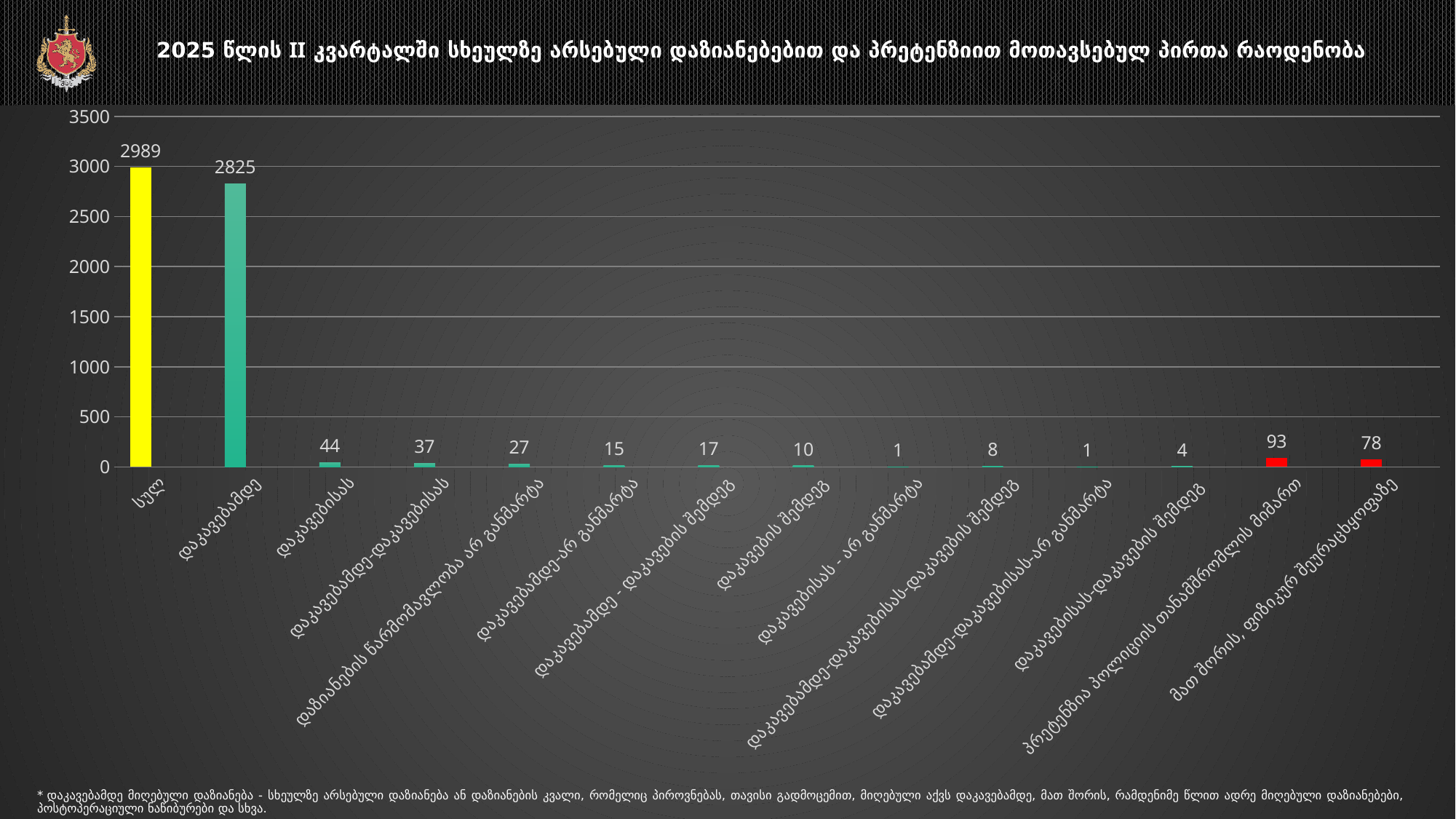
What is the value for პრეტენზია პოლიციის თანამშრომლის მიმართ? 93 What kind of chart is shown on the slide? bar chart What is the value for დაკავებისას? 44 Which is larger, the value for დაკავებისას or the value for დაკავებამდე-დაკავებისას? დაკავებისას What is the difference between the values for სულ and დაკავებამდე? 164 How many categories are shown on the x axis? 14 Is the value for დაკავებამდე greater or less than 2500? greater What is the lowest value shown on the chart? 1 Which category has the highest value? სულ What is the value for სულ? 2989 What is the difference between the values for პრეტენზია პოლიციის თანამშრომლის მიმართ and მათ შორის, ფიზიკურ შეურაცხყოფაზე? 15 What is the value for დაკავებამდე? 2825